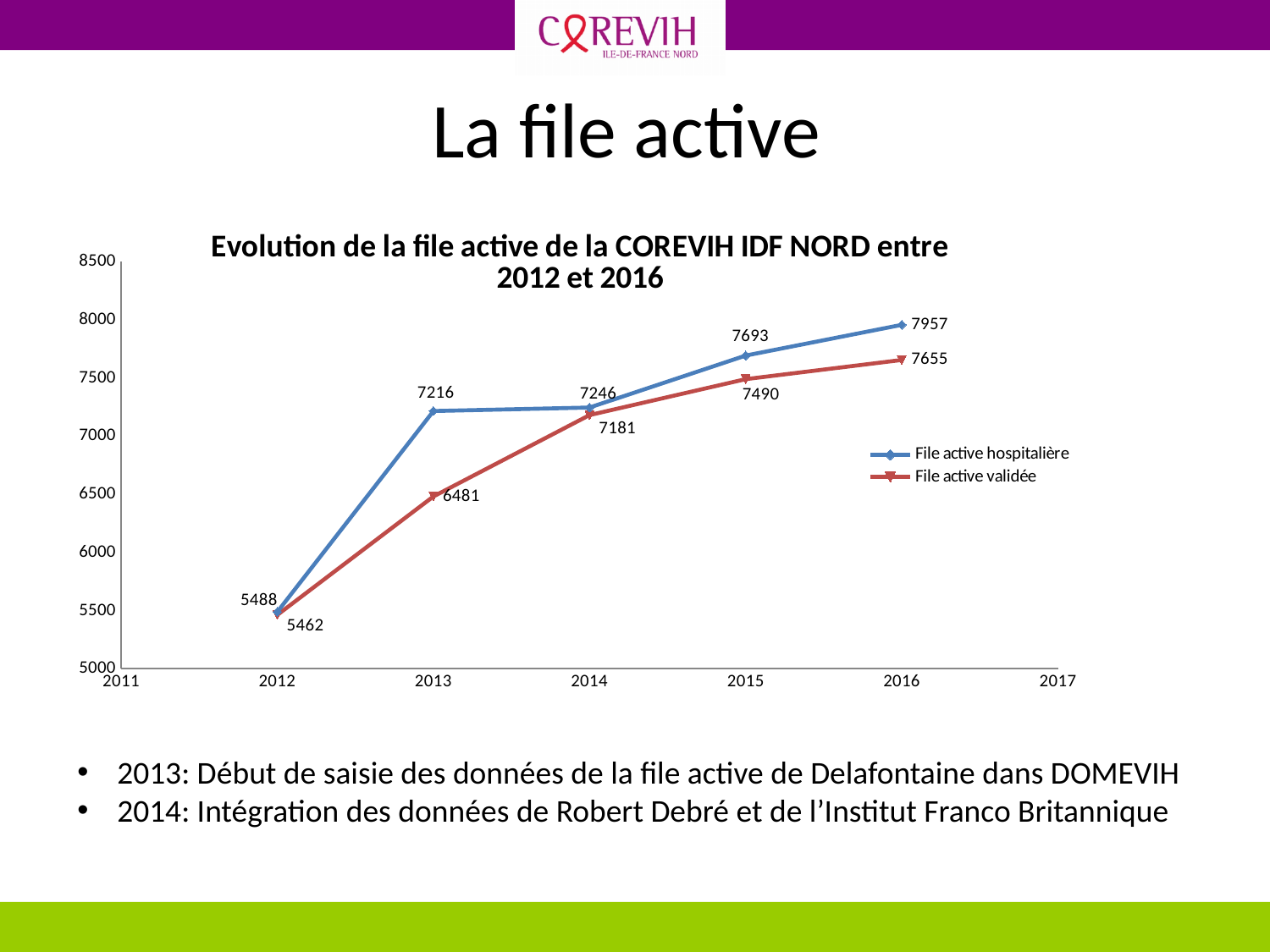
How many data points are plotted for File active validée? 5 How many series does the legend list? 2 What kind of chart is shown? Line chart In which year is File active hospitalière lowest? 2012 What is the value of File active validée in 2015? 7490 In which year is File active validée highest? 2016 Which is larger in 2015: File active hospitalière or File active validée? File active hospitalière What is the difference between File active hospitalière in 2016 and in 2012? 2469 What is the difference between File active hospitalière and File active validée in 2013? 735 Does File active validée rise or fall from 2012 to 2016? Rise What is the value of File active hospitalière in 2016? 7957 What is the value of File active validée in 2013? 6481